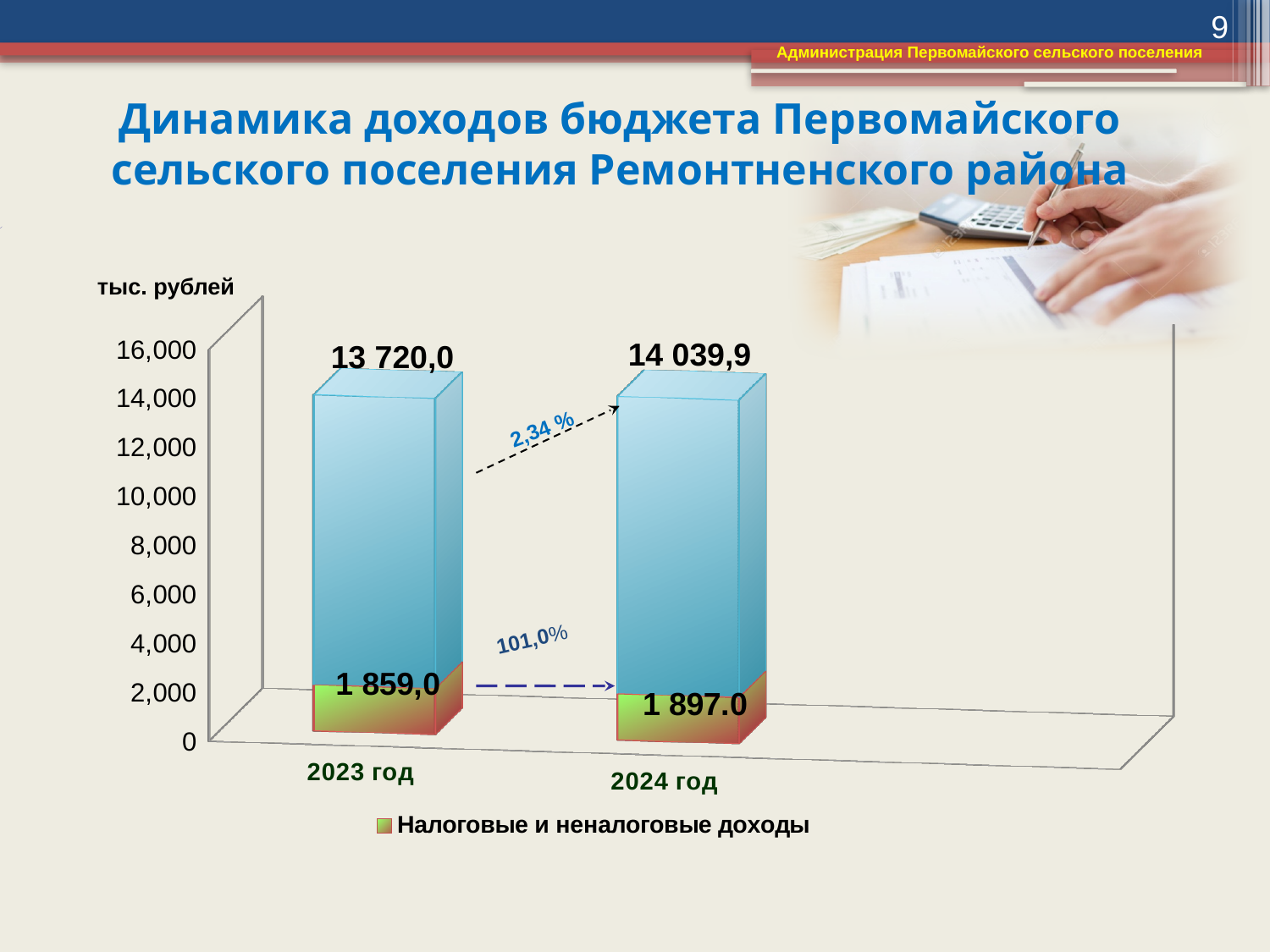
Do the total bar values rise or fall from 2023 год to 2024 год? rise How many years (categories) are shown on the x axis of the chart? 2 What kind of chart is shown on the slide? bar chart How many series does the chart legend list? 1 What value is labelled at the top of the bar for 2024 год? 14 039,9 What value is labelled at the top of the bar for 2023 год? 13 720,0 Which year has the higher total bar value, 2023 год or 2024 год? 2024 год What is the value of Налоговые и неналоговые доходы for 2024 год? 1 897.0 Is the total value for 2023 год greater or less than 12,000? greater What unit label is shown above the vertical axis of the chart? тыс. рублей By how much does the total labelled for 2024 год exceed the total labelled for 2023 год? 319,9 What is the value of Налоговые и неналоговые доходы for 2023 год? 1 859,0